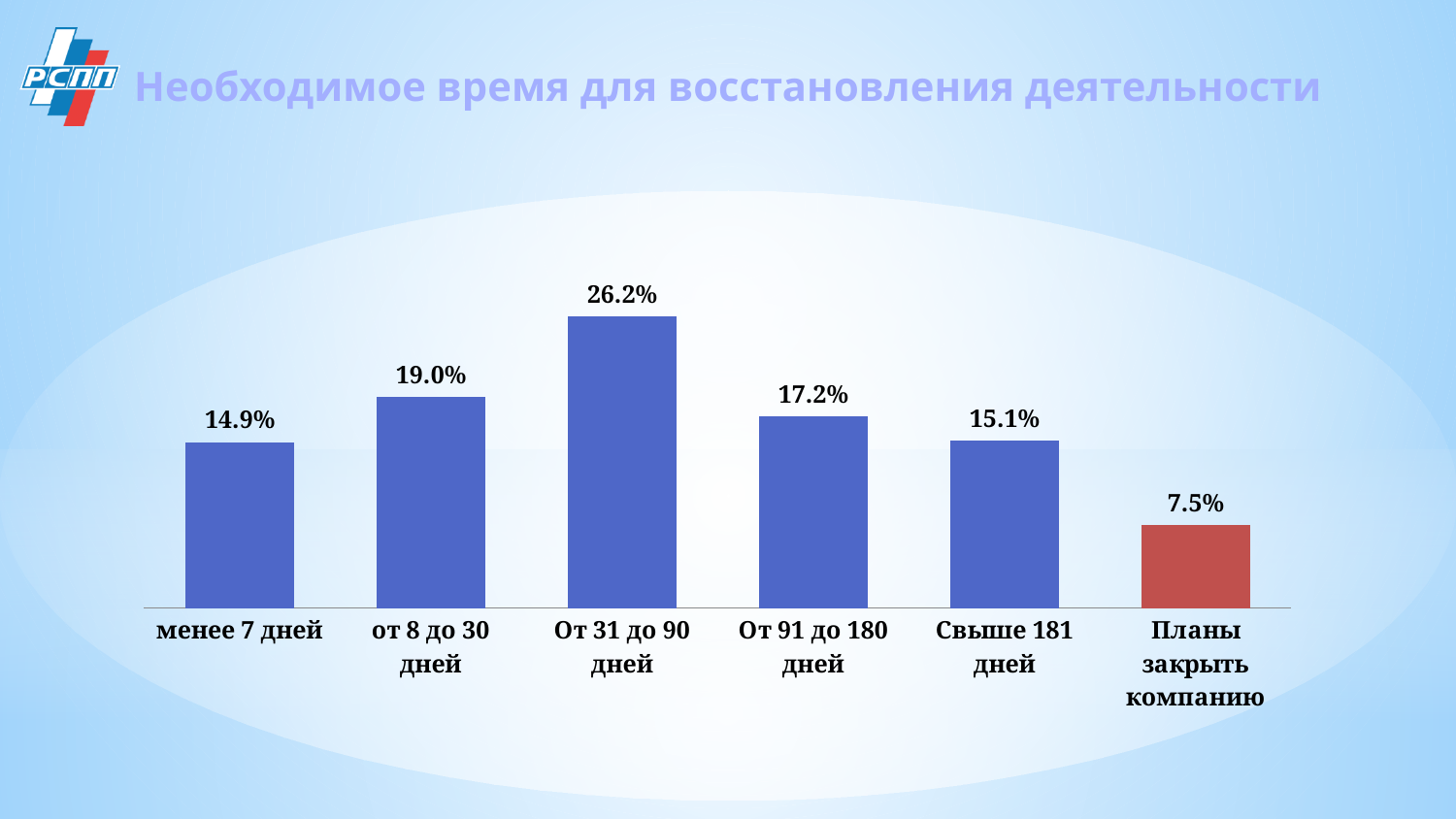
Which category has the lowest value? Планы закрыть компанию What is the value for "От 31 до 90 дней"? 26.2% What type of chart is shown on the slide? Bar chart What is the difference between the values for "От 31 до 90 дней" and "от 8 до 30 дней"? 7.2% Which is larger: the value for "от 8 до 30 дней" or the value for "От 91 до 180 дней"? от 8 до 30 дней How many categories are shown in the chart? 6 What is the value for "Планы закрыть компанию"? 7.5% Which bar is coloured differently (red) from the others? Планы закрыть компанию What is the title of the chart on the slide? Необходимое время для восстановления деятельности Which category has the highest value? От 31 до 90 дней What is the value for "Свыше 181 дней"? 15.1% What is the value for "менее 7 дней"? 14.9%